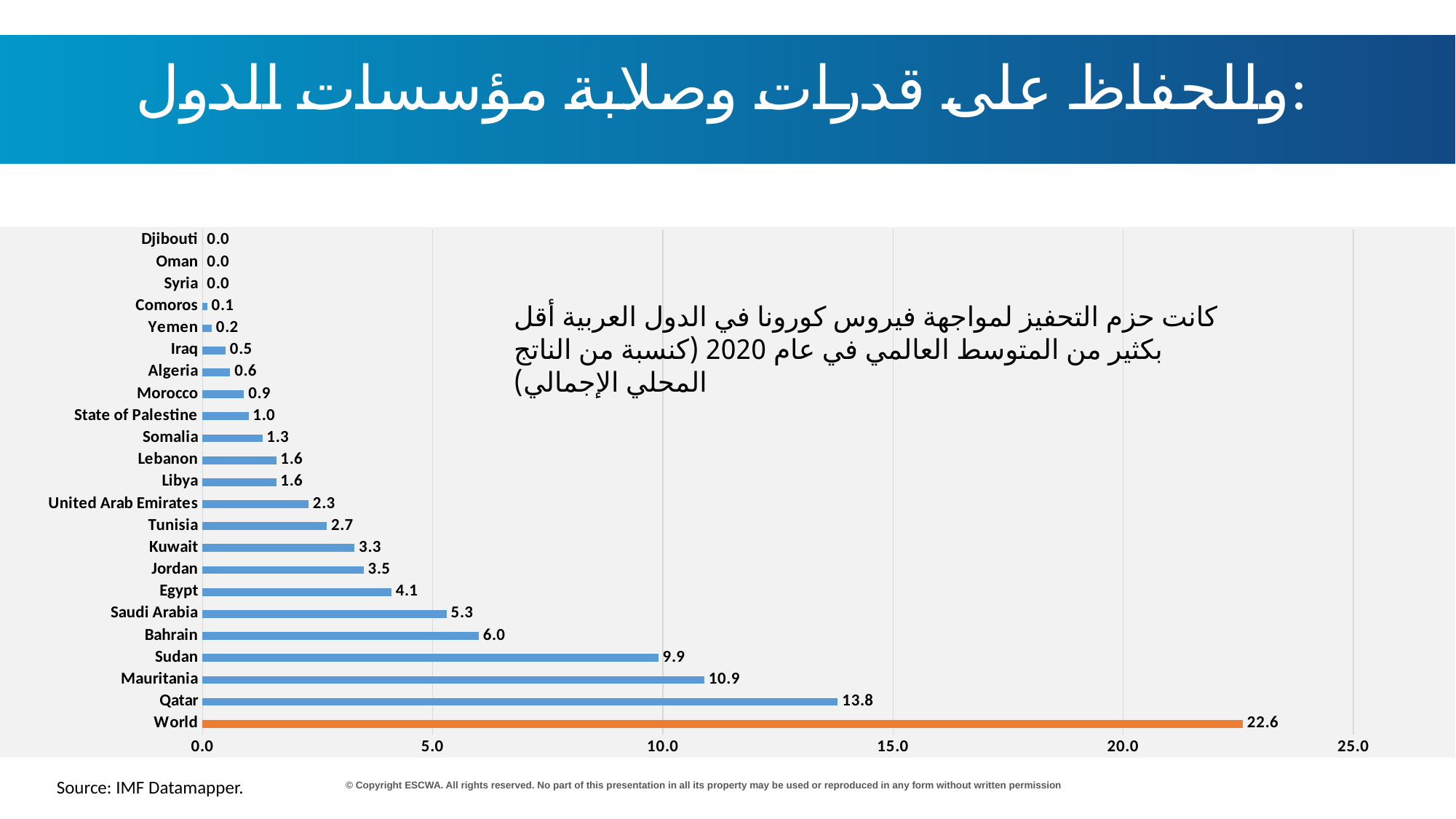
What kind of chart is shown on the slide? Bar chart How many categories are shown on the chart? 23 Is the value for Mauritania greater or less than 10.0? greater Which category has the highest value? World What is the value for Qatar? 13.8 What is the value for World? 22.6 What is the difference between the World value and the Qatar value? 8.8 Which has a larger value, Tunisia or Kuwait? Kuwait What is the value for Saudi Arabia? 5.3 Which has a larger value, Egypt or Jordan? Egypt What is the difference between the values for Sudan and Bahrain? 3.9 What is the value for Mauritania? 10.9